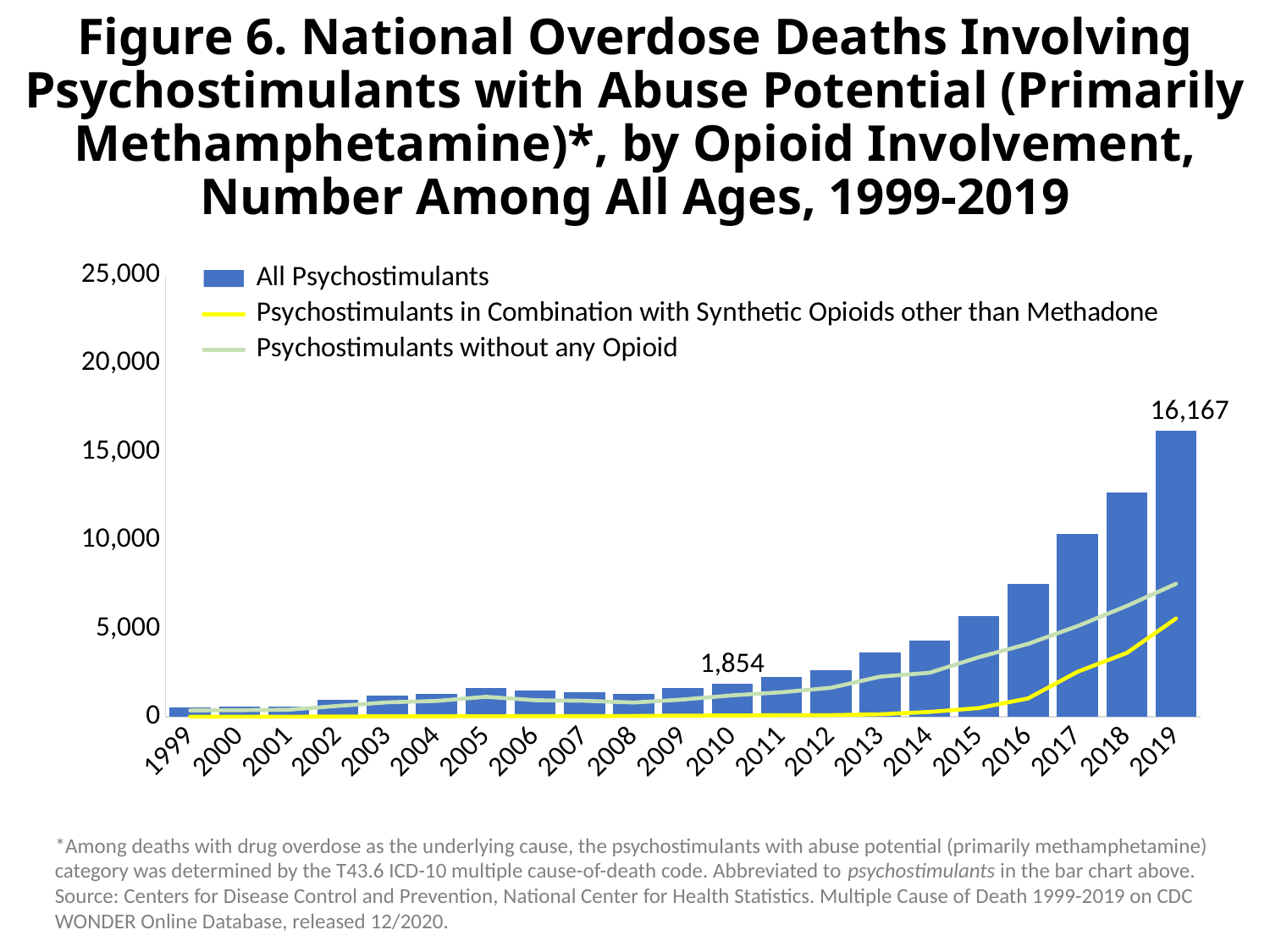
What kind of chart is used to show the All Psychostimulants series? bar chart Do the All Psychostimulants values generally rise or fall from 1999 to 2019? rise Which year has the highest All Psychostimulants bar? 2019 How many years are shown on the x axis? 21 What is the value for All Psychostimulants in 2010? 1,854 What is the difference between the All Psychostimulants values for 2019 and 2010? 14,313 How many series does the legend list? 3 Is the All Psychostimulants value for 2018 greater or less than 10,000? greater Which year has the lowest All Psychostimulants bar? 1999 Which year has the larger All Psychostimulants bar, 2017 or 2018? 2018 Is the All Psychostimulants value for 2013 greater or less than 5,000? less What is the value for All Psychostimulants in 2019? 16,167